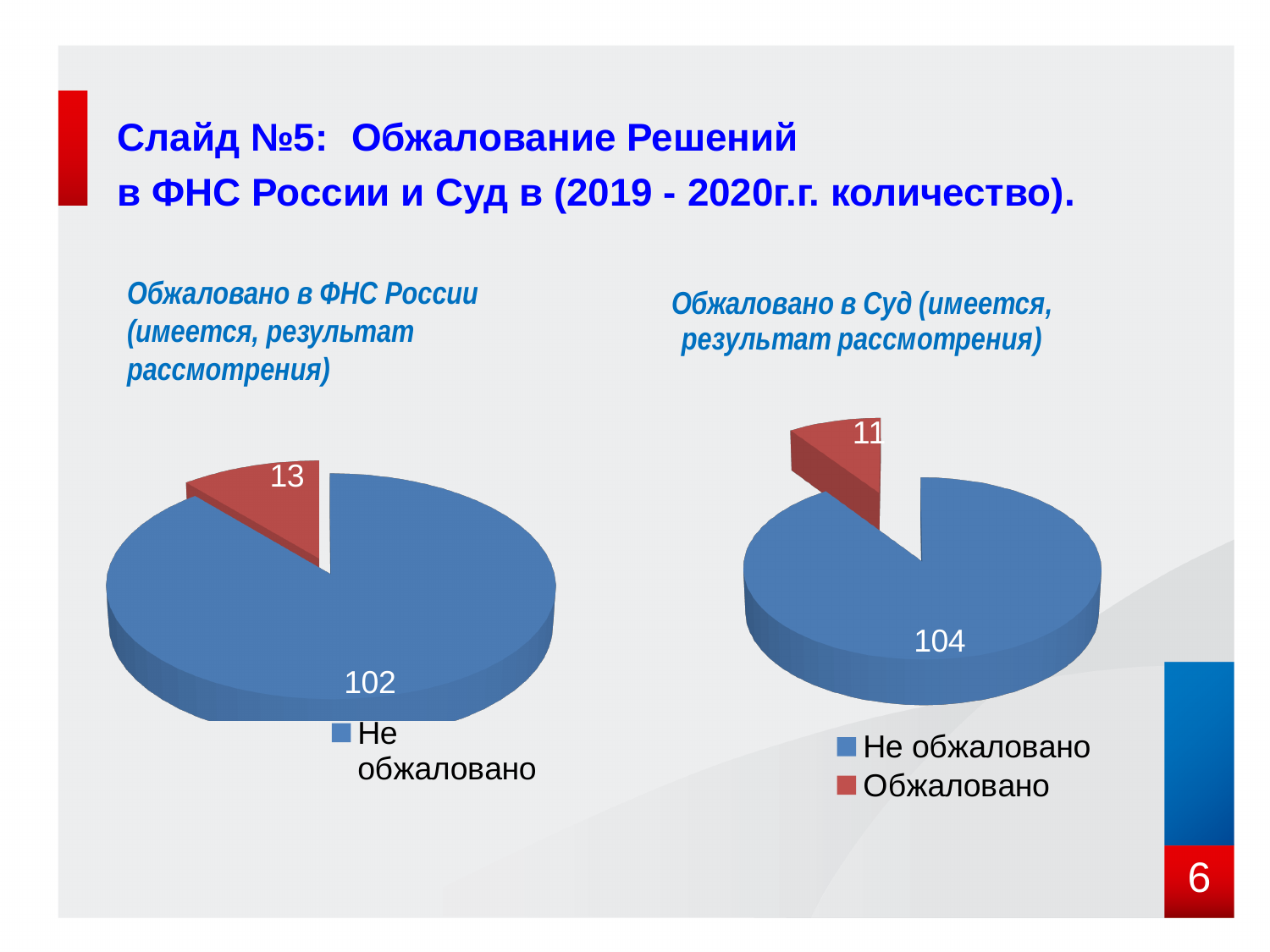
In the right chart ("Обжаловано в Суд"), what is the difference between "Не обжаловано" and "Обжаловано"? 93 In the left chart ("Обжаловано в ФНС России"), what is the value for "Не обжаловано"? 102 In the left chart ("Обжаловано в ФНС России"), what value is shown on the red slice? 13 Which is larger: the "Не обжаловано" value in the left chart or the "Не обжаловано" value in the right chart? The right chart (104) In the left chart ("Обжаловано в ФНС России"), what is the difference between the blue slice (102) and the red slice (13)? 89 How many entries does the legend of the right chart ("Обжаловано в Суд") list? 2 In the right chart ("Обжаловано в Суд"), which category has the smallest slice? Обжаловано What kind of chart is shown on the left of the slide, titled "Обжаловано в ФНС России"? Pie chart How many slices does the right chart ("Обжаловано в Суд") have? 2 In the right chart ("Обжаловано в Суд"), which category has the largest slice? Не обжаловано In the right chart ("Обжаловано в Суд"), what is the value for "Обжаловано"? 11 In the right chart ("Обжаловано в Суд"), what is the value for "Не обжаловано"? 104